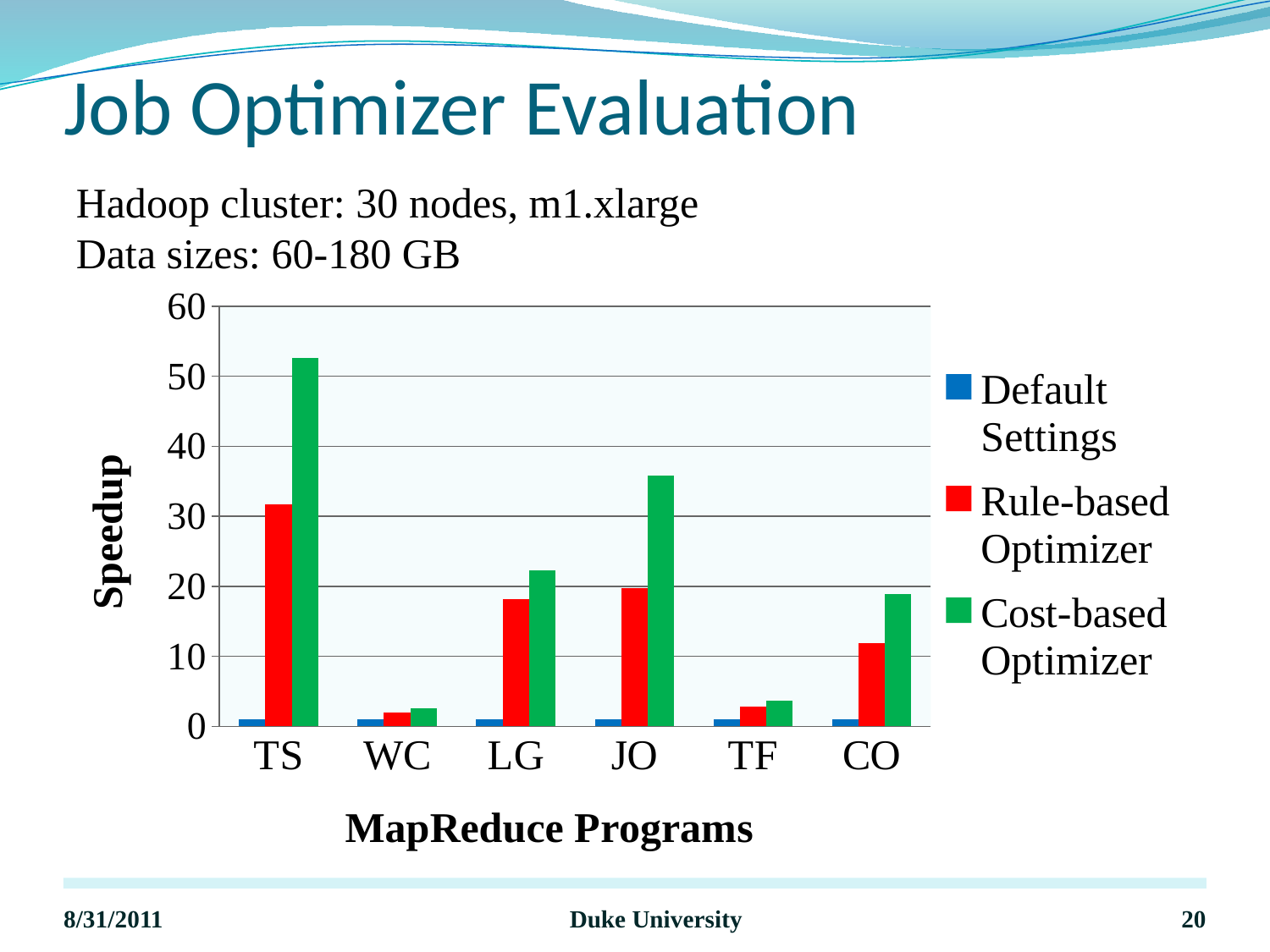
What is the label of the y axis? Speedup Is the Cost-based Optimizer speedup for JO greater or less than 40? less Is the Cost-based Optimizer speedup for WC greater or less than 10? less How many MapReduce programs are shown on the x axis? 6 How many series does the legend list? 3 Is the Rule-based Optimizer speedup for TS greater or less than 30? greater Which MapReduce program has the highest Rule-based Optimizer speedup? TS Which has the larger Cost-based Optimizer speedup, JO or LG? JO Which MapReduce program has the highest Cost-based Optimizer speedup? TS What kind of chart is shown on the slide? bar chart